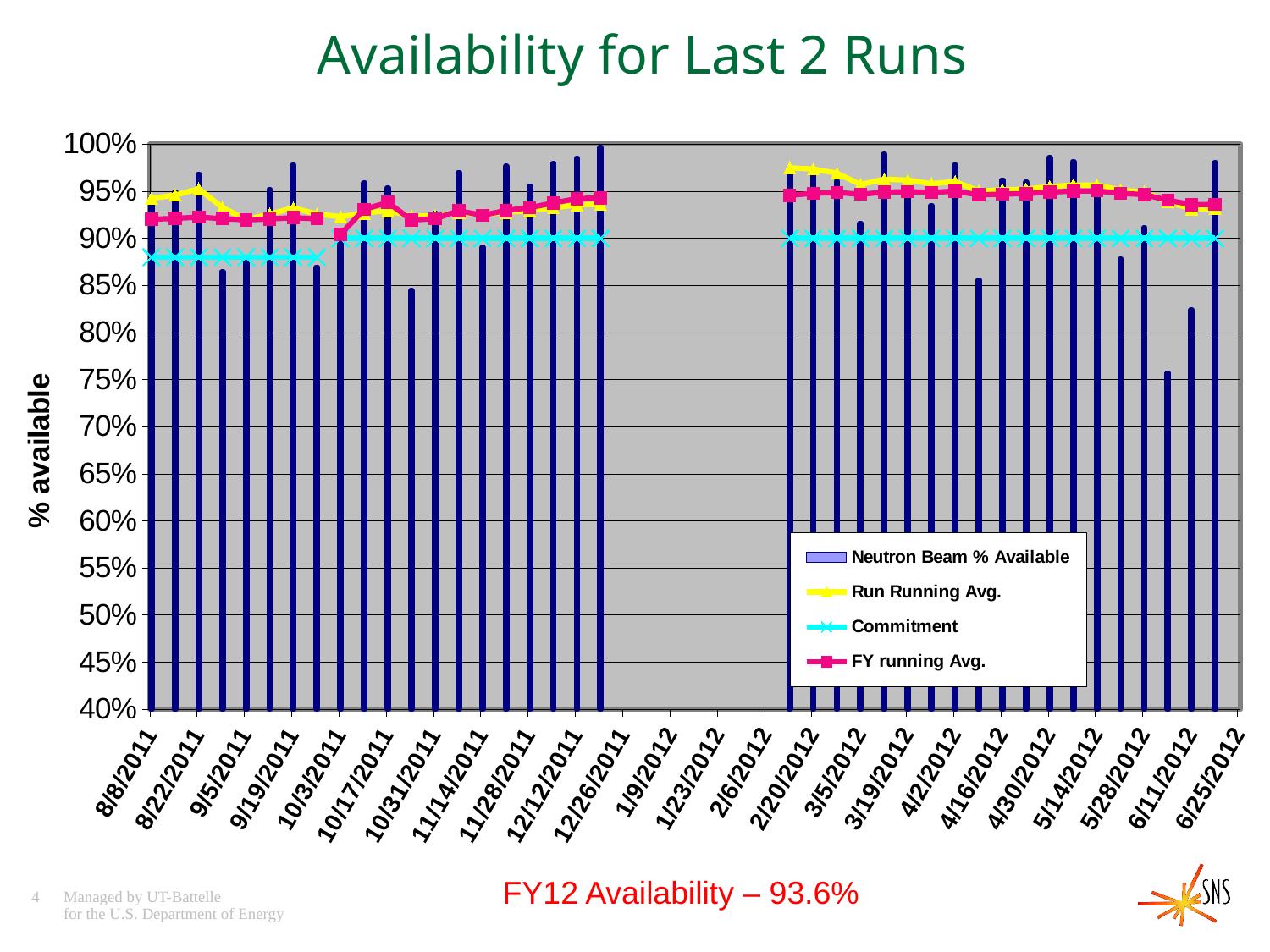
What is the Commitment value shown for 2/20/2012? 90% What kind of chart is shown on the slide? Combined bar and line chart Which series is drawn in yellow in the chart? Run Running Avg. How many series does the chart legend list? 4 What is the title of the chart? Availability for Last 2 Runs Which is larger at 2/20/2012, the Run Running Avg. or the Commitment? Run Running Avg. Does the Run Running Avg. line rise or fall from 2/20/2012 to 6/25/2012? fall What is the label on the vertical axis of the chart? % available Is the Neutron Beam % Available bar at 8/8/2011 greater or less than 90%? greater Is the Neutron Beam % Available bar at 6/11/2012 greater or less than 85%? less